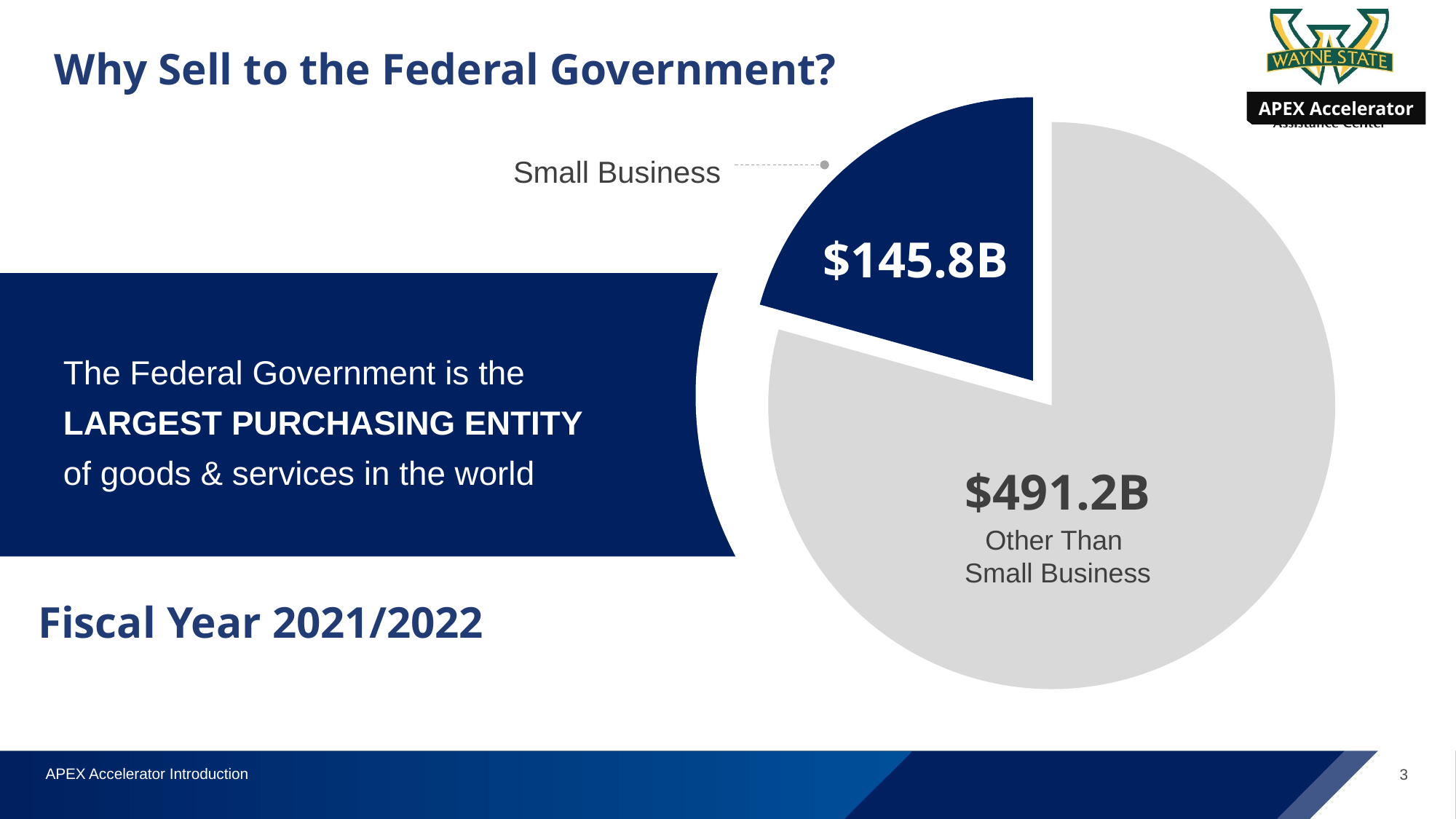
What colour is the Small Business slice in the pie chart? dark blue What kind of chart is shown on the slide? pie chart What is the value for Other Than Small Business in the pie chart? $491.2B How many slices does the pie chart have? 2 Which slice of the pie chart is the smallest? Small Business Which slice of the pie chart is the largest? Other Than Small Business What is the total of the two slices in the pie chart? $637.0B Which fiscal year does the pie chart data refer to, according to the slide? Fiscal Year 2021/2022 What is the difference between the Other Than Small Business value and the Small Business value? $345.4B Which is larger, the Small Business slice or the Other Than Small Business slice? Other Than Small Business What is the value for Small Business in the pie chart? $145.8B